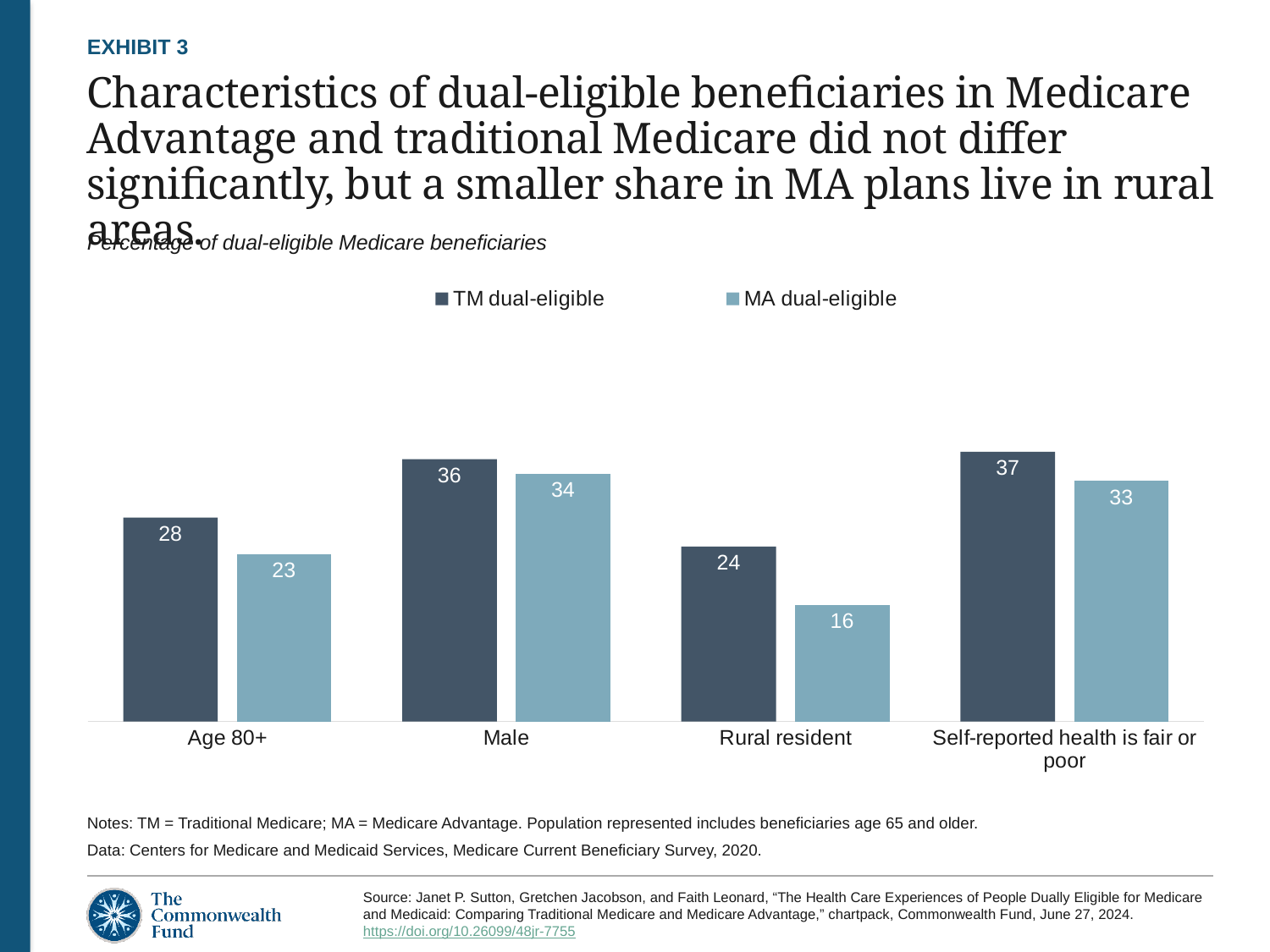
Which category has the lowest MA dual-eligible value? Rural resident What are the two series named in the legend? TM dual-eligible and MA dual-eligible What is the difference between the TM dual-eligible and MA dual-eligible values for Rural resident? 8 What kind of chart is shown on the slide? Bar chart How many categories are shown on the x axis? 4 Which is larger for Age 80+: the TM dual-eligible value or the MA dual-eligible value? TM dual-eligible Which category has the highest TM dual-eligible value? Self-reported health is fair or poor What is the difference between the TM dual-eligible and MA dual-eligible values for Self-reported health is fair or poor? 4 What is the value for MA dual-eligible in the Rural resident category? 16 What is the value for TM dual-eligible in the Age 80+ category? 28 What is the value for MA dual-eligible in the Male category? 34 How many series does the legend list? 2